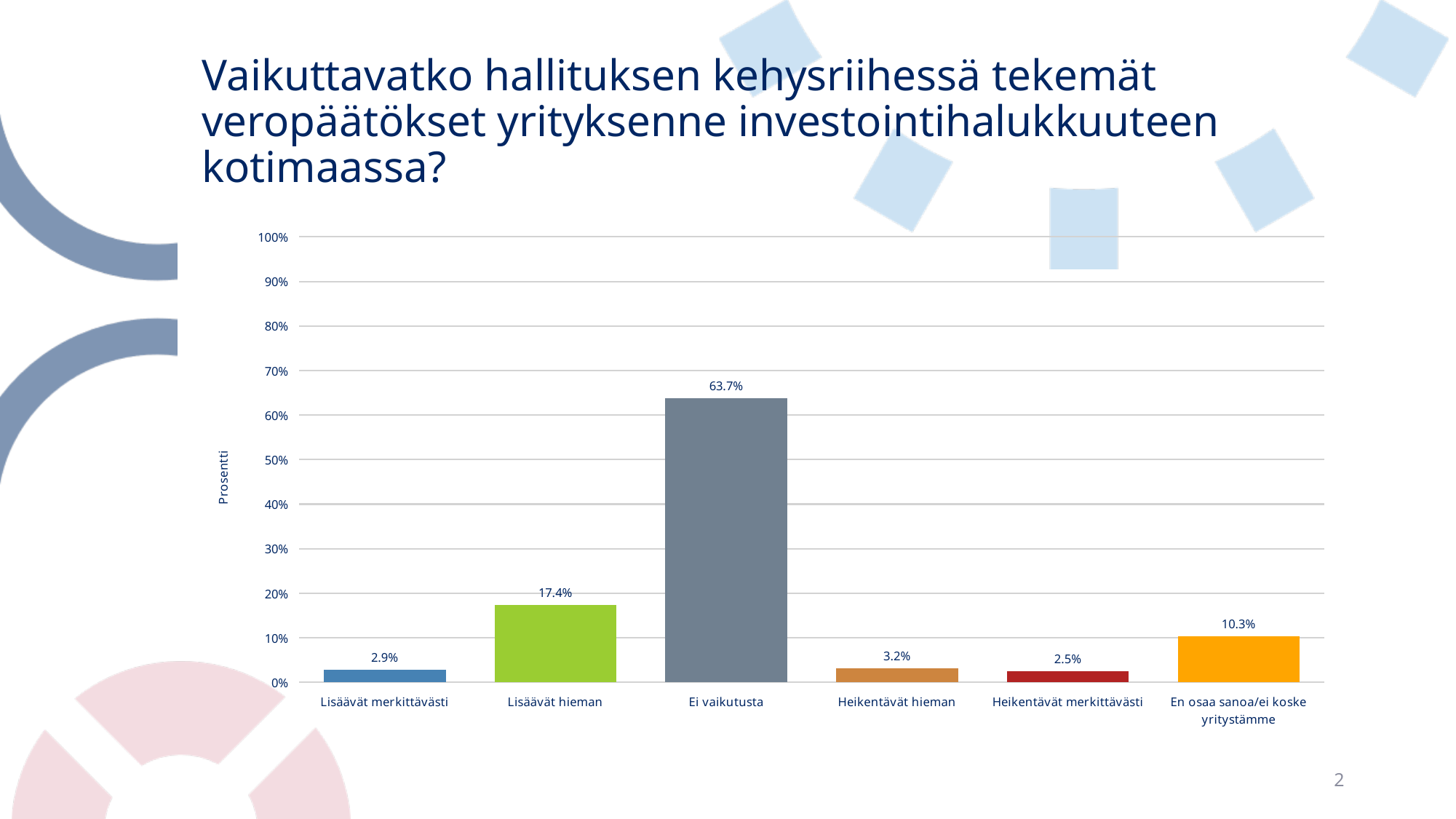
How many categories are shown on the x axis? 6 What is the value for "En osaa sanoa/ei koske yritystämme"? 10.3% Which category has the lowest value? Heikentävät merkittävästi What is the difference between the values for "Heikentävät hieman" and "Lisäävät merkittävästi"? 0.3% What is the value for "Heikentävät merkittävästi"? 2.5% What is the value for "Lisäävät hieman"? 17.4% What kind of chart is shown on the slide? Bar chart What is the label of the vertical axis? Prosentti Which category has the highest value? Ei vaikutusta What is the value for "Ei vaikutusta"? 63.7% What is the difference between the values for "Ei vaikutusta" and "Lisäävät hieman"? 46.3% Which is larger, the value for "Lisäävät hieman" or the value for "En osaa sanoa/ei koske yritystämme"? Lisäävät hieman